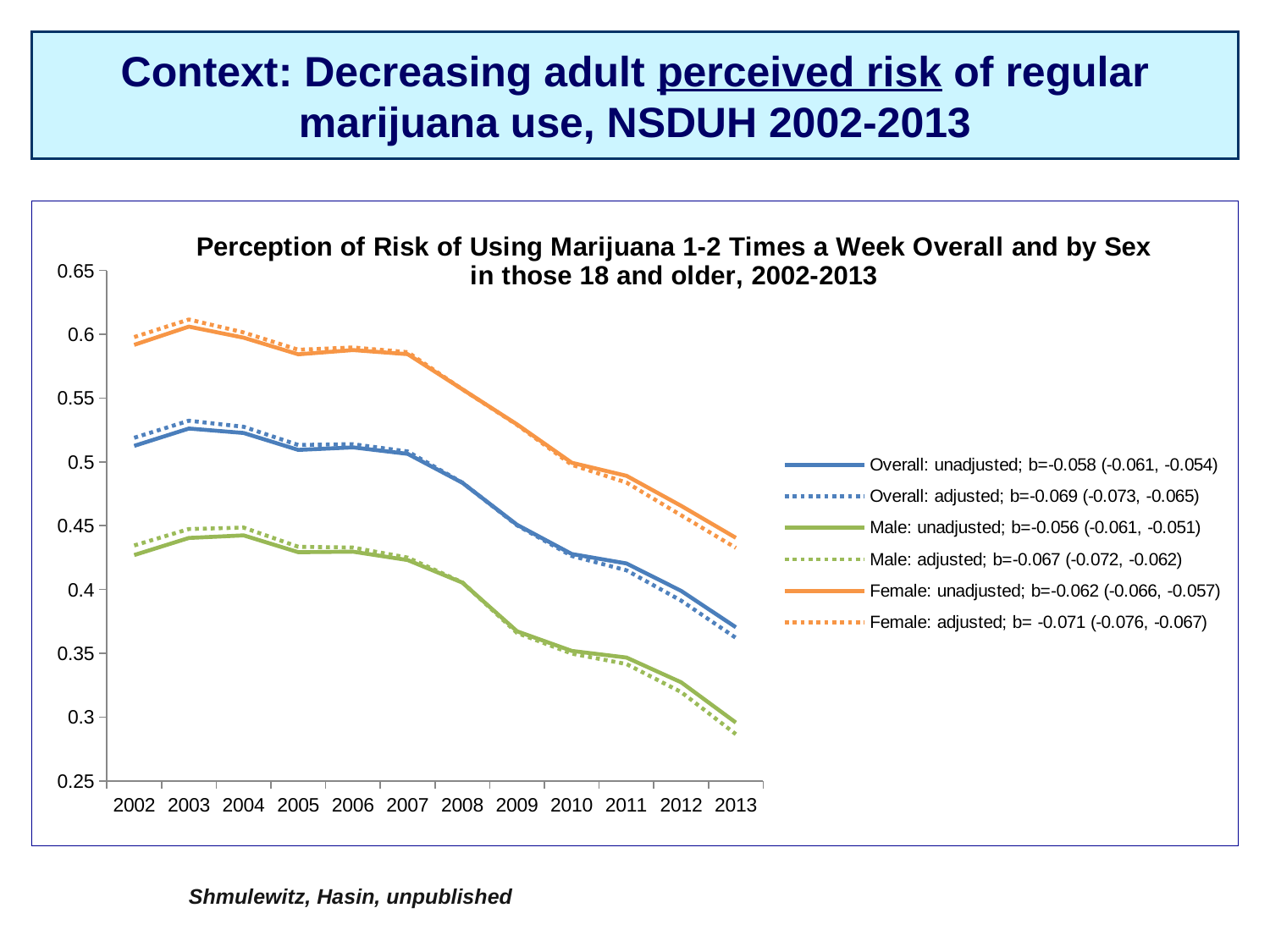
Is the value for Female: unadjusted in 2002 greater or less than 0.55? greater Is the value for Overall: unadjusted in 2013 greater or less than 0.35? greater Is the value for Female: unadjusted in 2013 greater or less than 0.45? less Which group has the lowest perceived risk values across all years: Overall, Male, or Female? Male What kind of chart is shown on the slide? line chart Which is larger in 2007, the Female: unadjusted value or the Male: unadjusted value? Female: unadjusted Do the values for the Overall: unadjusted series rise or fall from 2002 to 2013? fall What is the b coefficient shown in the legend for the Overall: unadjusted series? -0.058 (-0.061, -0.054) How many series does the legend list? 6 How many years are shown along the x axis? 12 What is the title of the chart? Perception of Risk of Using Marijuana 1-2 Times a Week Overall and by Sex in those 18 and older, 2002-2013